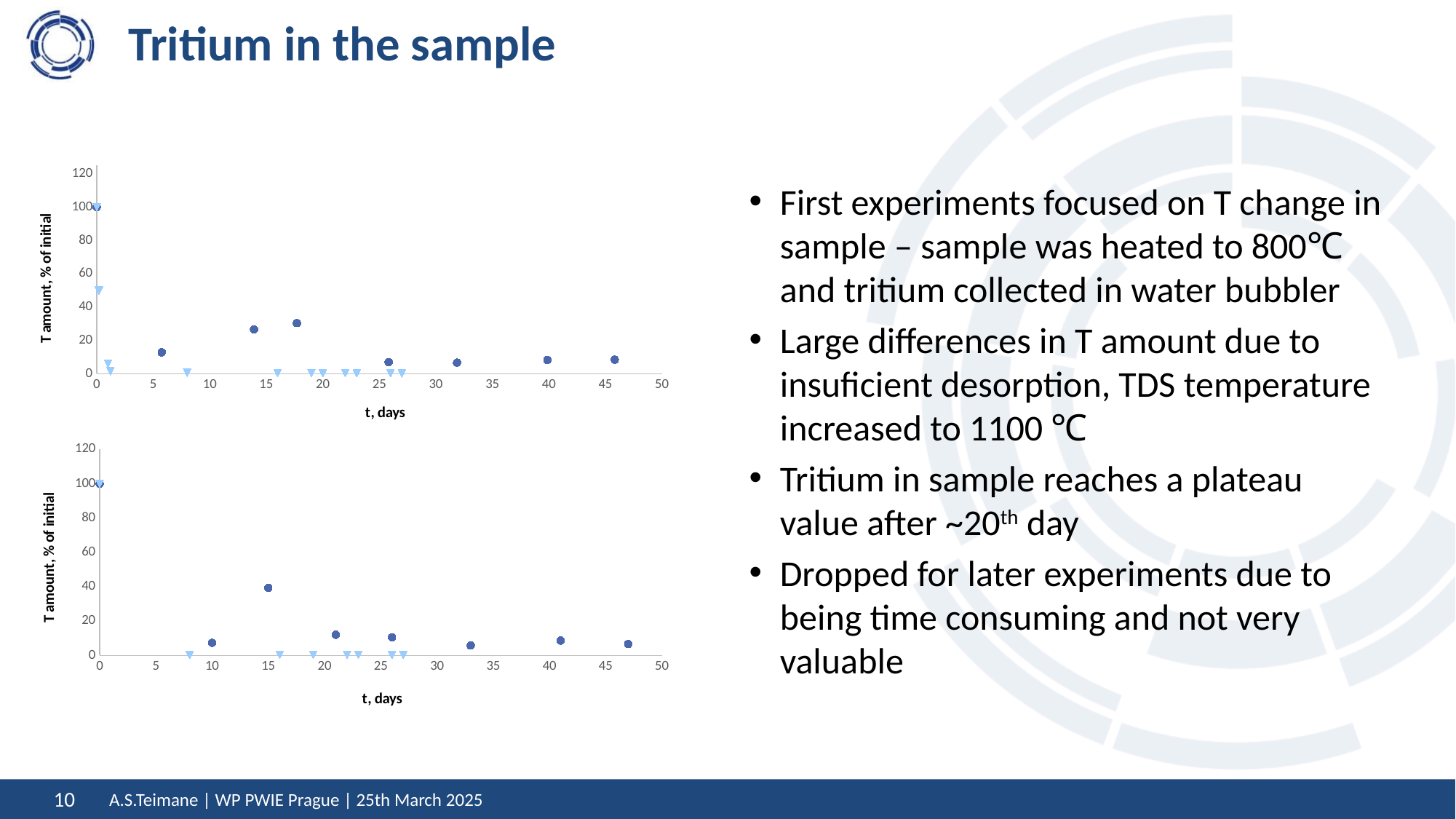
What kind of chart is the top chart on the slide? scatter chart In the bottom chart, what is the highest tick value shown on the vertical axis? 120 In the top chart, is the value of the dark circle point at about 18 days greater or less than 20? greater In the top chart, is the value of the dark circle point at about 32 days greater or less than 20? less How many charts are shown on the slide? 2 In the bottom chart, what is the label of the horizontal axis? t, days In the bottom chart, is the value of the dark circle point at about 33 days greater or less than 20? less In the top chart, do the dark circle values overall rise or fall from day 0 to day 45? fall In the top chart, at which value of t (days) is the highest point plotted? 0 In the bottom chart, which dark circle point is higher: the one at about 15 days or the one at about 21 days? the one at about 15 days In the top chart, what is the label of the vertical axis? T amount, % of initial